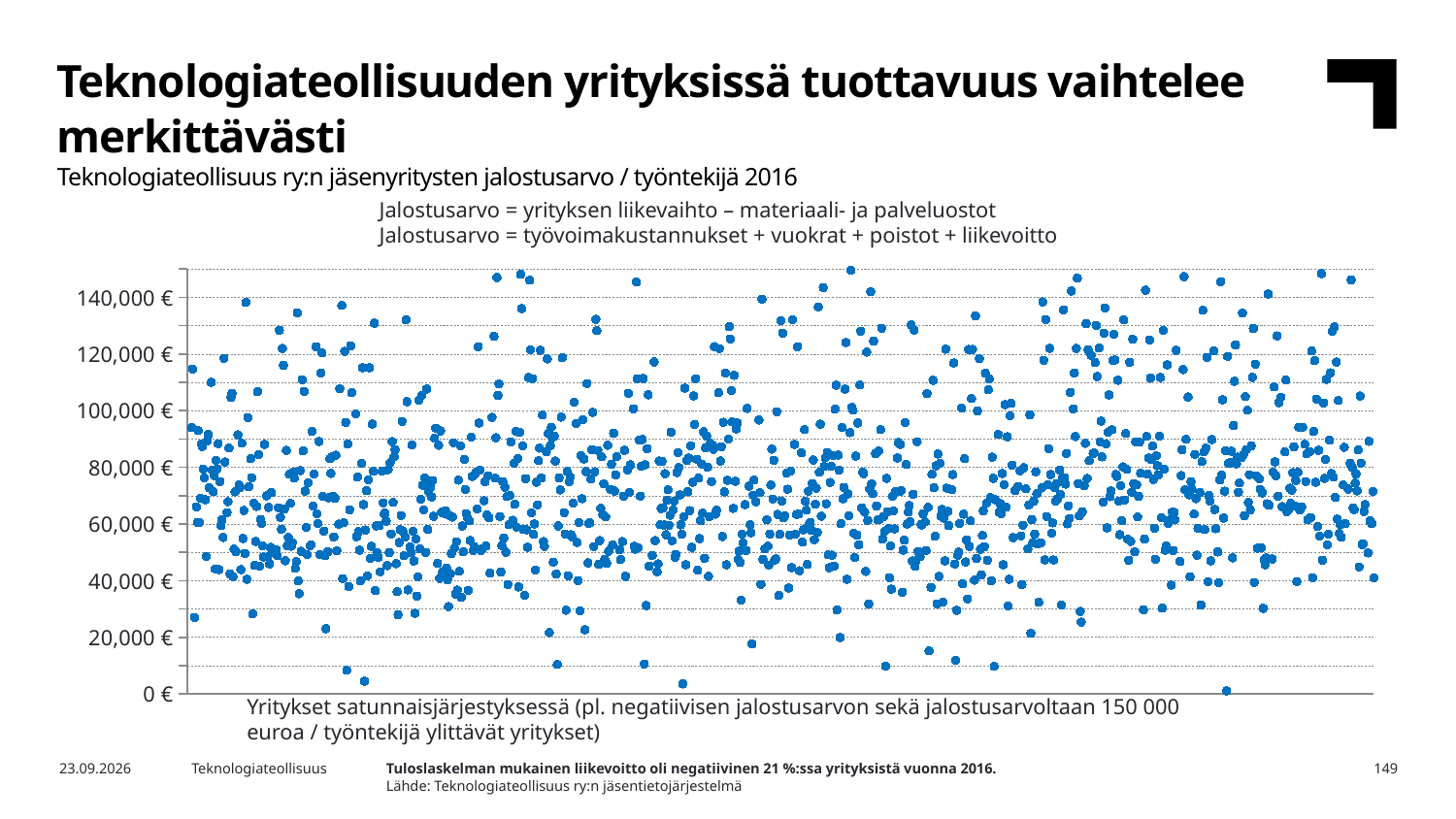
Do the plotted values show a clear rising or falling trend from left to right along the x axis? no What is the highest value labelled on the vertical axis of the chart? 140,000 € What year does the chart's data refer to, according to the chart title? 2016 Are there any plotted points with a value greater than 140,000 €? yes Are there any plotted points with a value less than 20,000 €? yes What kind of chart is shown on the slide? scatter chart